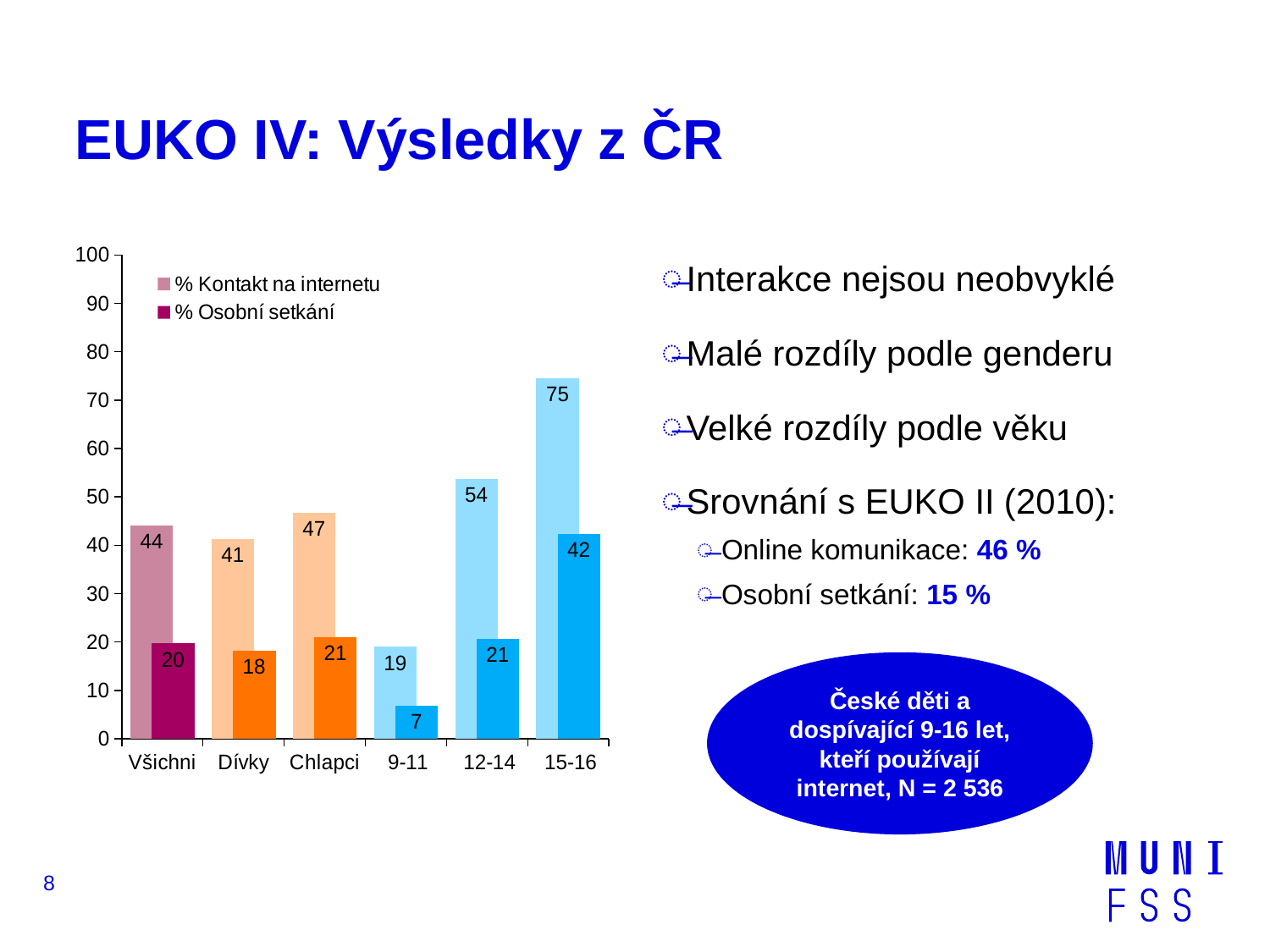
What is the difference between % Kontakt na internetu for Chlapci and for Dívky? 6 How many series does the legend list? 2 Which category has the highest value for % Kontakt na internetu? 15-16 What is the value of % Kontakt na internetu for Všichni? 44 Do the values of % Kontakt na internetu rise or fall across the age groups 9-11, 12-14 and 15-16? rise How many categories are shown on the x axis? 6 Which is larger: % Osobní setkání for 15-16 or for 12-14? 15-16 Is the value of % Kontakt na internetu for 12-14 greater or less than 50? greater Which category has the lowest value for % Osobní setkání? 9-11 What kind of chart is shown on the slide? bar chart What is the value of % Osobní setkání for 9-11? 7 What is the value of % Kontakt na internetu for 15-16? 75